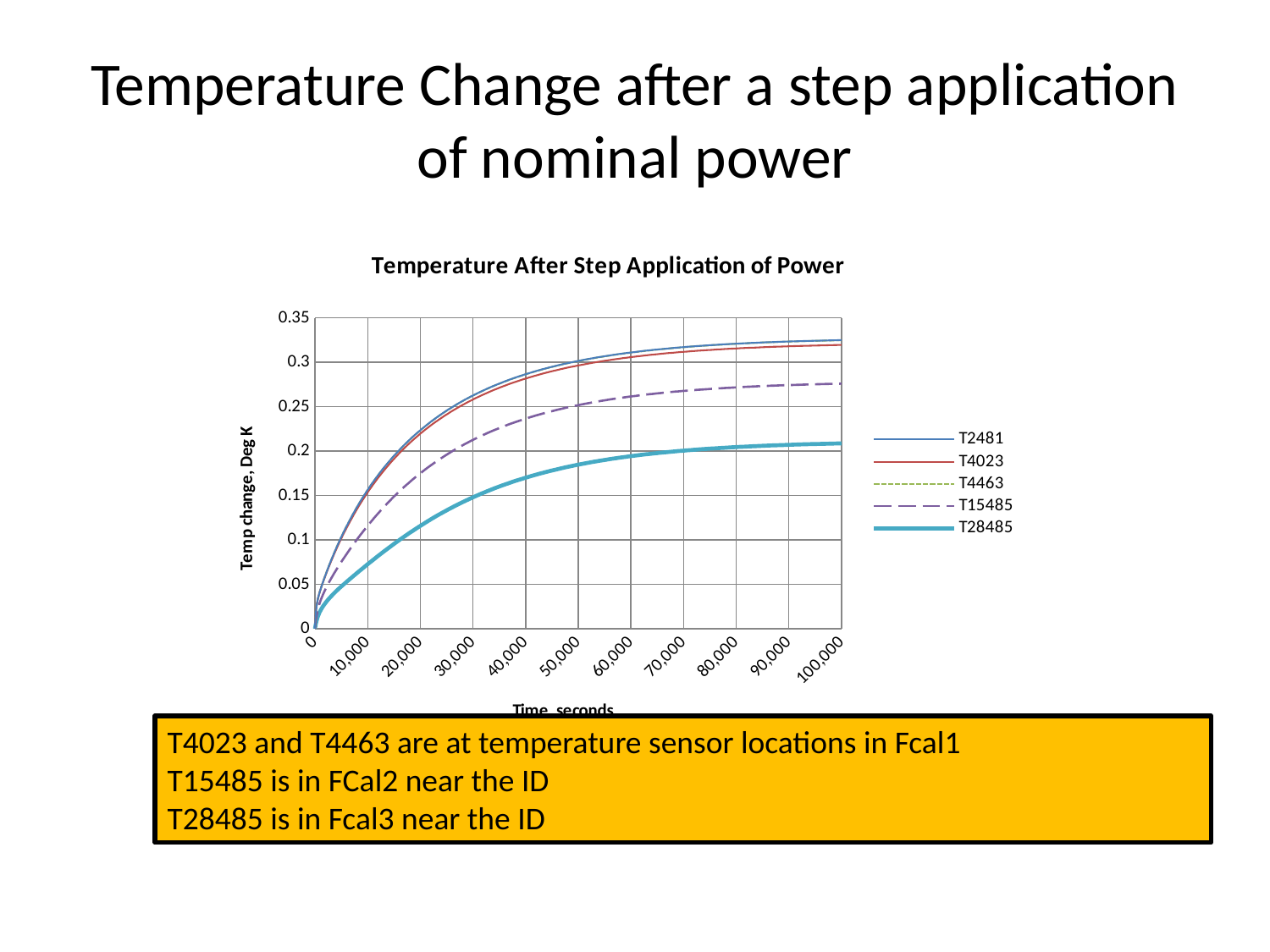
Is the value of T28485 at 100,000 seconds greater or less than 0.25? less Is the value of T2481 at 100,000 seconds greater or less than 0.3? greater What is the title of the chart? Temperature After Step Application of Power Is the value of T4023 at 20,000 seconds greater or less than 0.2? greater At 50,000 seconds, which series has the larger value, T15485 or T28485? T15485 What is the label of the vertical axis of the chart? Temp change, Deg K At 100,000 seconds, which series has the larger value, T2481 or T28485? T2481 How many series does the chart legend list? 5 Do the values of the T28485 series rise or fall as time increases along the x axis? rise Which series has the lowest value at 100,000 seconds? T28485 What kind of chart is shown on the slide? line chart